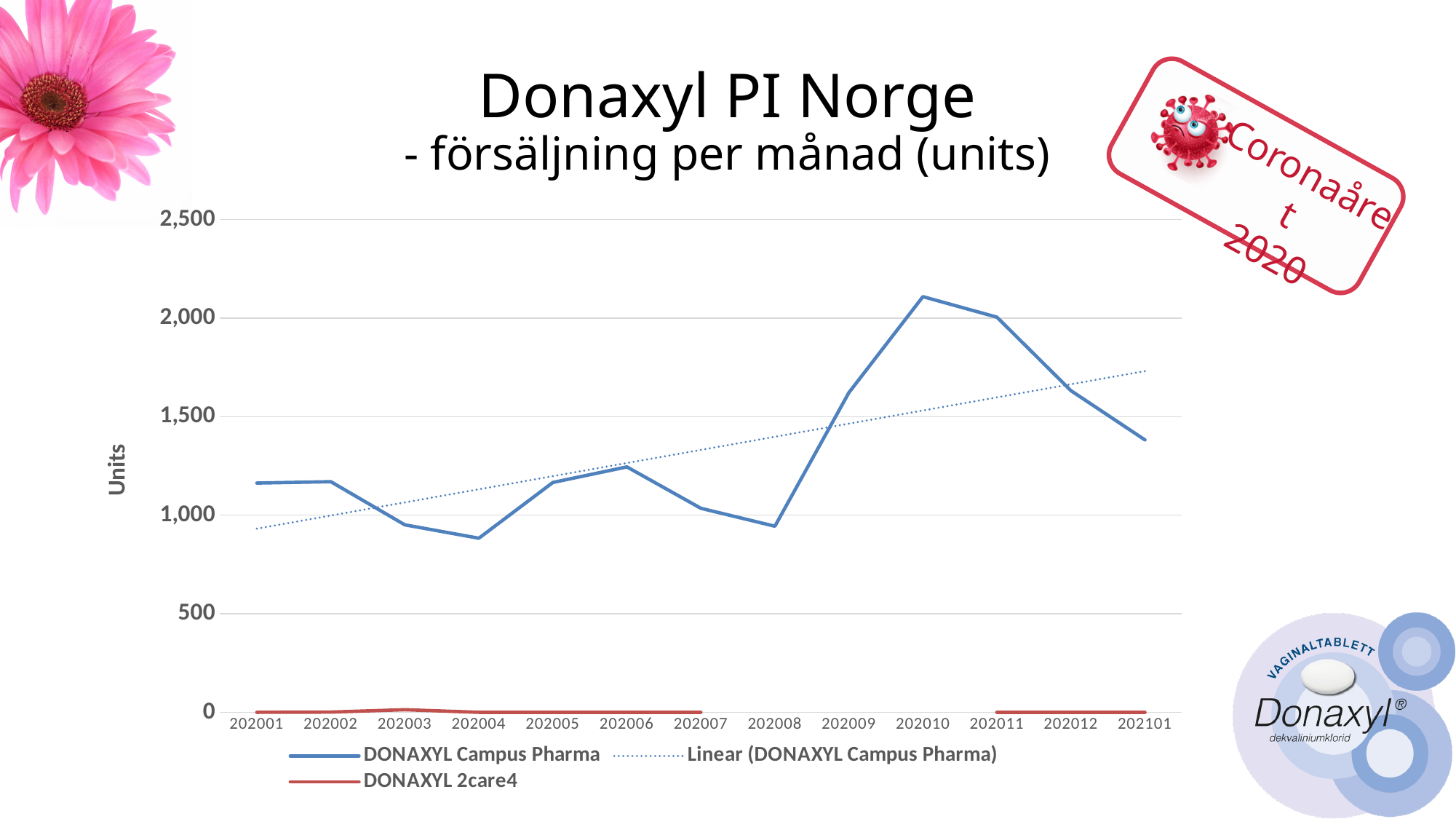
How many entries does the legend list? 3 Is the DONAXYL Campus Pharma value for 202004 greater or less than 1,000? less Does the DONAXYL Campus Pharma line rise or fall from 202010 to 202101? Fall What kind of chart is shown on the slide? Line chart Which is larger for DONAXYL Campus Pharma, the value for 202011 or the value for 202008? 202011 Is the DONAXYL Campus Pharma value for 202101 greater or less than 1,500? less Is the DONAXYL Campus Pharma value for 202010 greater or less than 2,000? greater Does the DONAXYL Campus Pharma line rise or fall from 202008 to 202010? Rise What is the label on the vertical axis of the chart? Units How many months are plotted along the x axis? 13 In which month does the DONAXYL Campus Pharma line reach its highest value? 202010